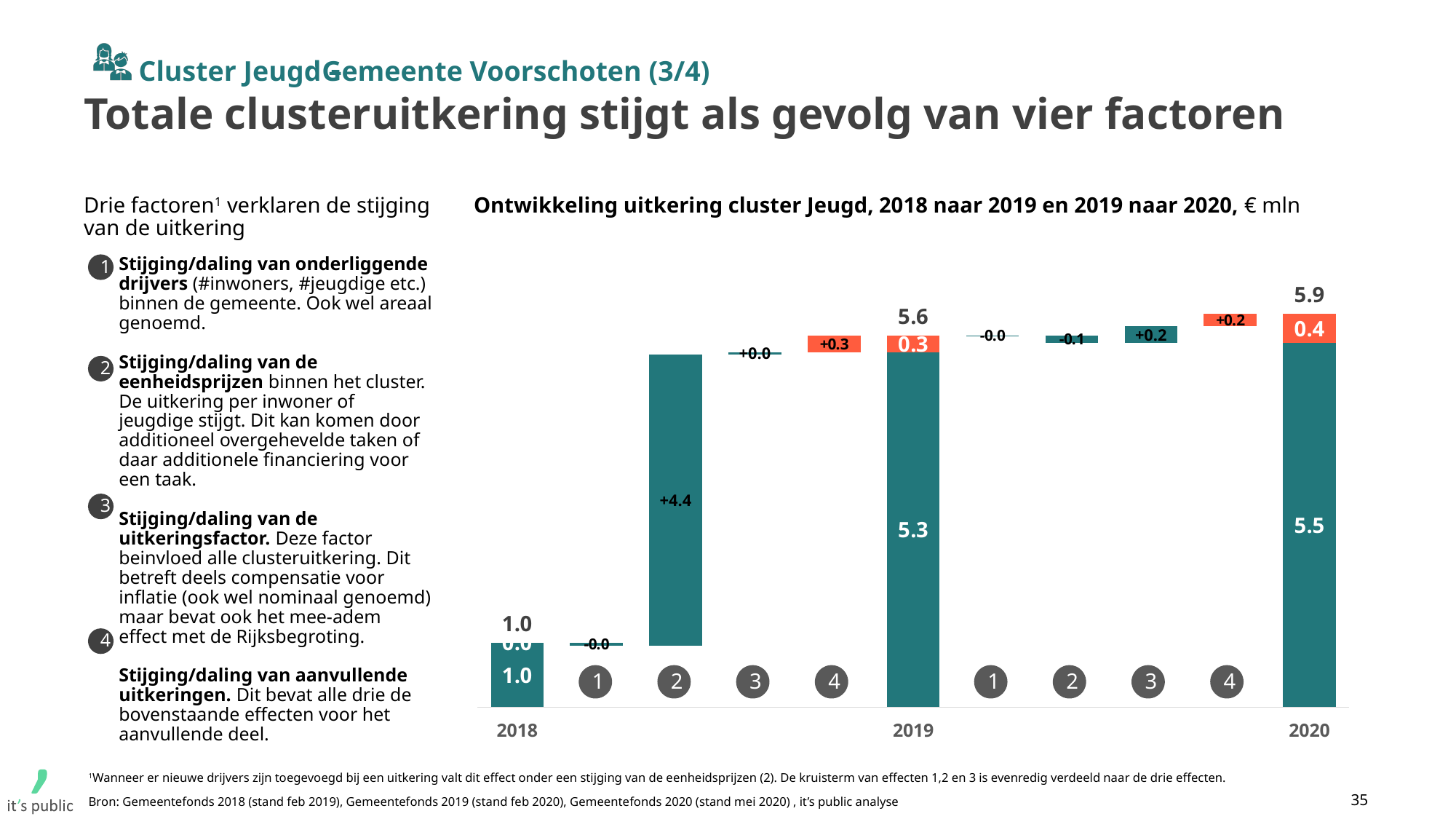
What is the total uitkering for cluster Jeugd in 2019 shown above the bar? 5.6 What is the value of the factor 2 step between 2019 and 2020? -0.1 Which is larger, the 2019 total or the 2020 total? 2020 total What is the value of the factor 4 step between 2018 and 2019? +0.3 What is the total uitkering for cluster Jeugd in 2018 shown above the bar? 1.0 In what unit are the values in the chart expressed? € mln What is the total uitkering for cluster Jeugd in 2020 shown above the bar? 5.9 What is the difference between the 2019 total (5.6) and the 2018 total (1.0)? 4.6 What is the value of the teal (lower) segment of the 2020 bar? 5.5 Which factor step between 2018 and 2019 has the largest value? Factor 2 (+4.4) What is the value of the factor 2 step between 2018 and 2019? +4.4 What is the difference between the 2020 total (5.9) and the 2019 total (5.6)? 0.3